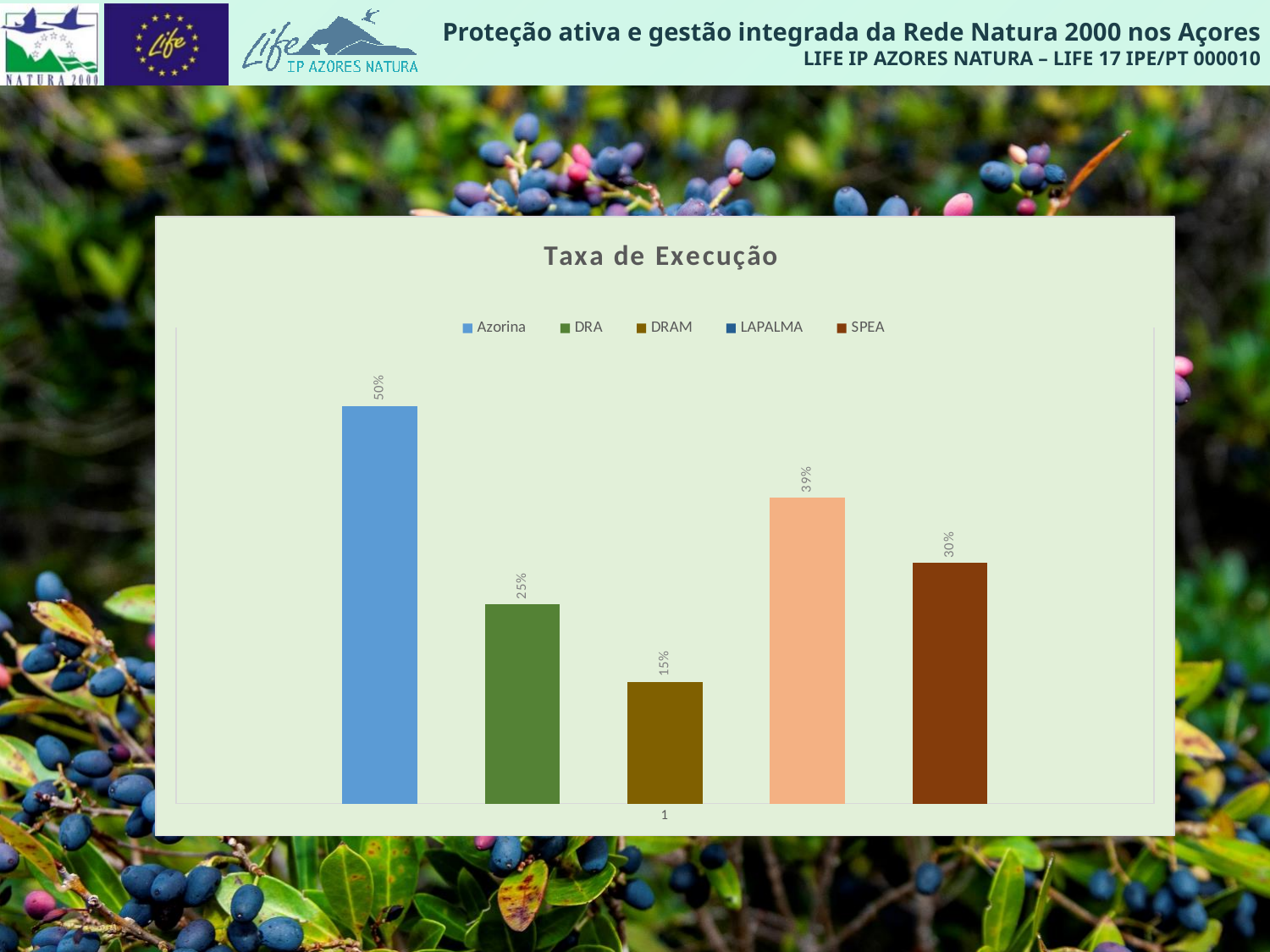
What is the value for LAPALMA? 39% What type of chart is shown on the slide? bar chart Which series has the highest value? Azorina How many series does the legend list? 5 What is the value for Azorina? 50% What is the value for DRA? 25% Which series has the lowest value? DRAM What is the value for SPEA? 30% Which is larger, the value for LAPALMA or the value for SPEA? LAPALMA What is the value for DRAM? 15% What is the difference between the values for Azorina and DRAM? 35% What is the title of the chart? Taxa de Execução